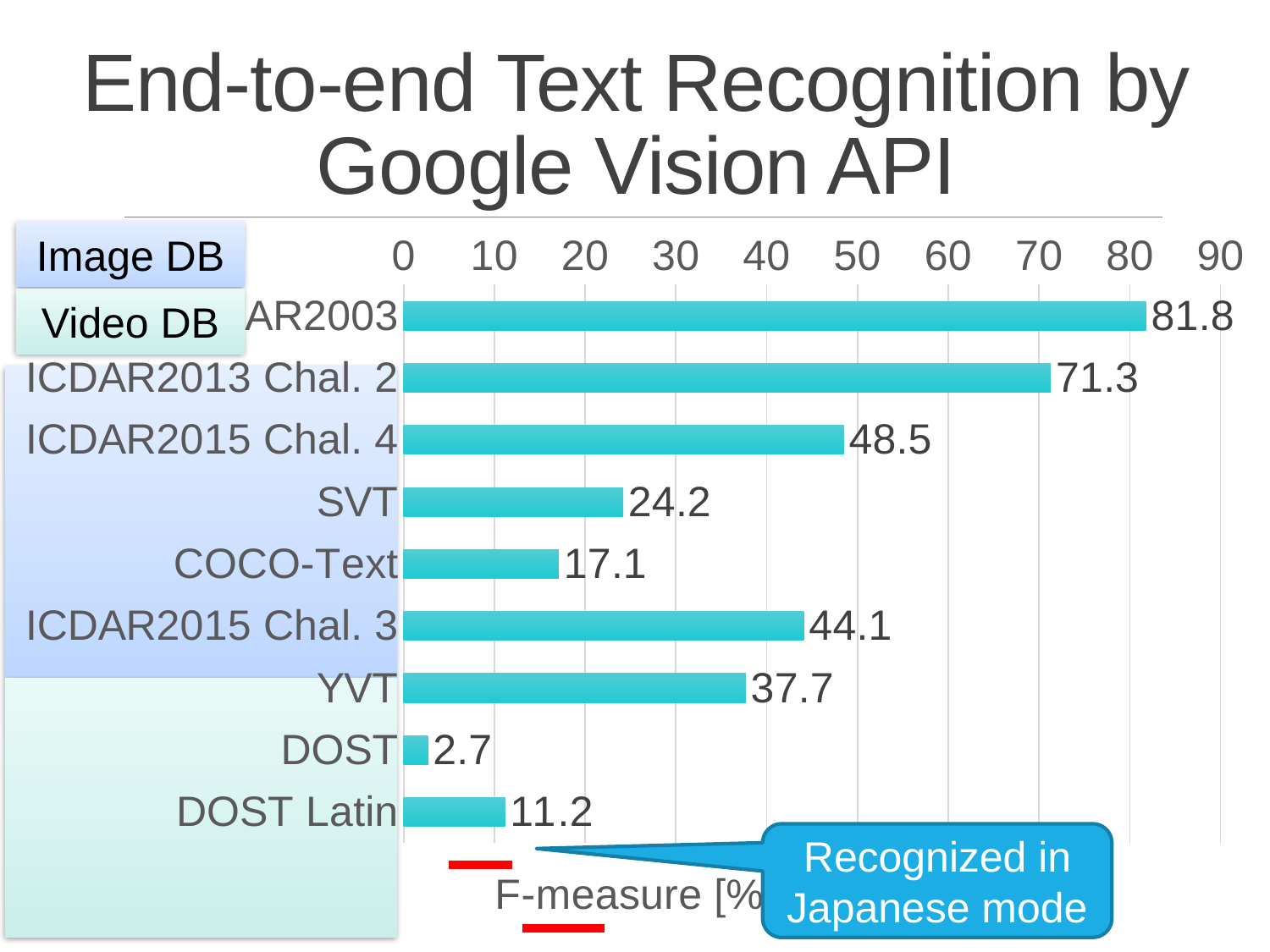
What is the value shown for DOST Latin? 11.2 Which has a larger value, YVT or SVT? YVT What is the value shown for SVT? 24.2 What is the value of the longest bar in the chart? 81.8 Is the value for ICDAR2015 Chal. 4 greater or less than 40? greater What kind of chart is shown on the slide? Bar chart How many bars are plotted in the chart? 9 What is the value shown for COCO-Text? 17.1 What is the difference between the values for ICDAR2015 Chal. 4 and ICDAR2015 Chal. 3? 4.4 What is the difference between the values for DOST Latin and DOST? 8.5 What is the F-measure value for ICDAR2013 Chal. 2? 71.3 Which category has the lowest value in the chart? DOST